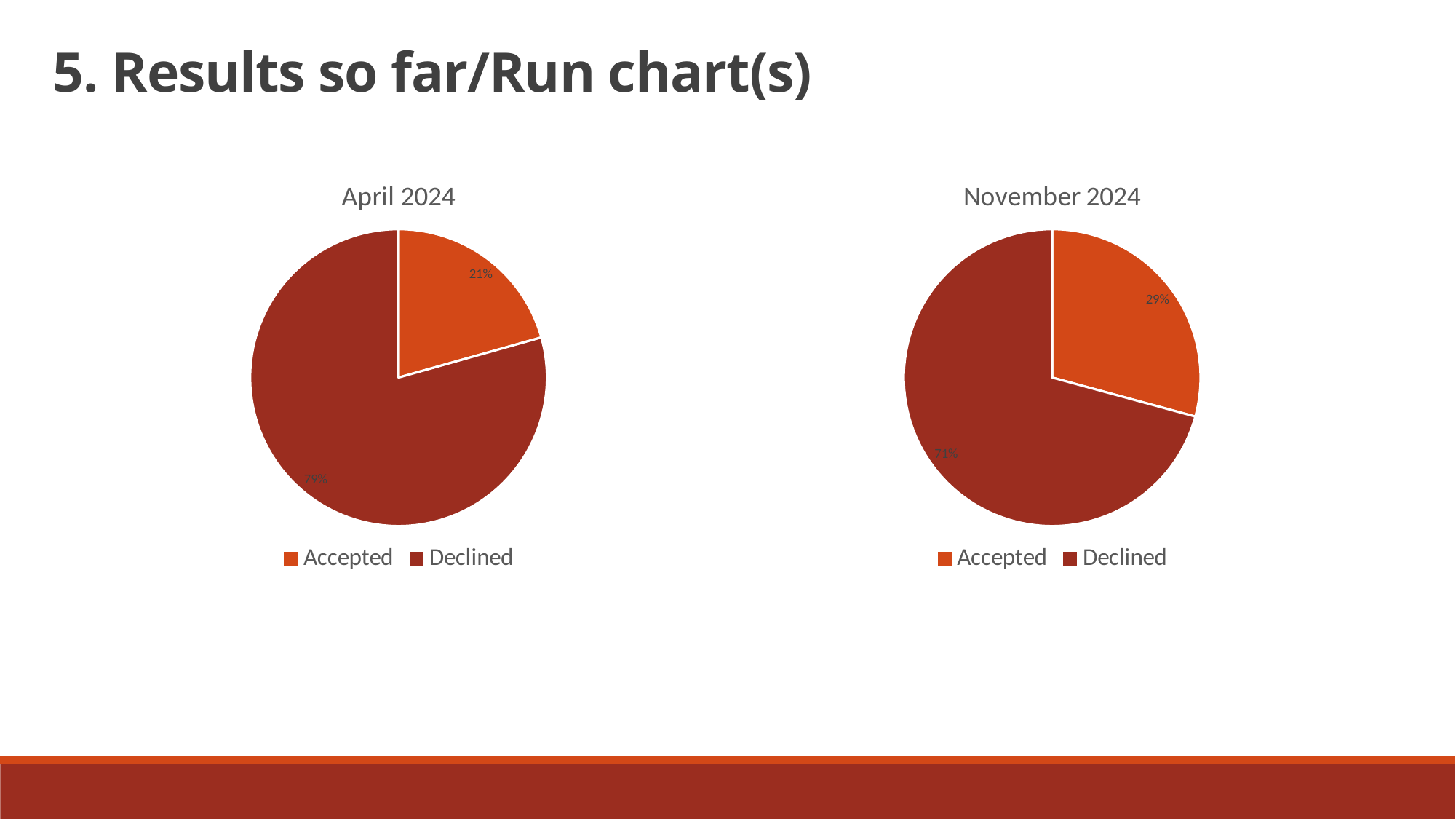
In the November 2024 chart, which slice is the smallest? Accepted What type of chart is the April 2024 chart? Pie chart Which chart has the larger Accepted share, April 2024 or November 2024? November 2024 How many slices does the November 2024 pie chart have? 2 In the November 2024 chart, what share of the pie is Declined? 71% In the November 2024 chart, what is the difference between the Declined and Accepted shares? 42% In the April 2024 chart, what is the difference between the Declined and Accepted shares? 58% In the April 2024 chart, what share of the pie is Declined? 79% In the April 2024 chart, which slice is the largest? Declined In the April 2024 chart, what share of the pie is Accepted? 21% In the April 2024 chart, what colour is the Accepted slice? Orange